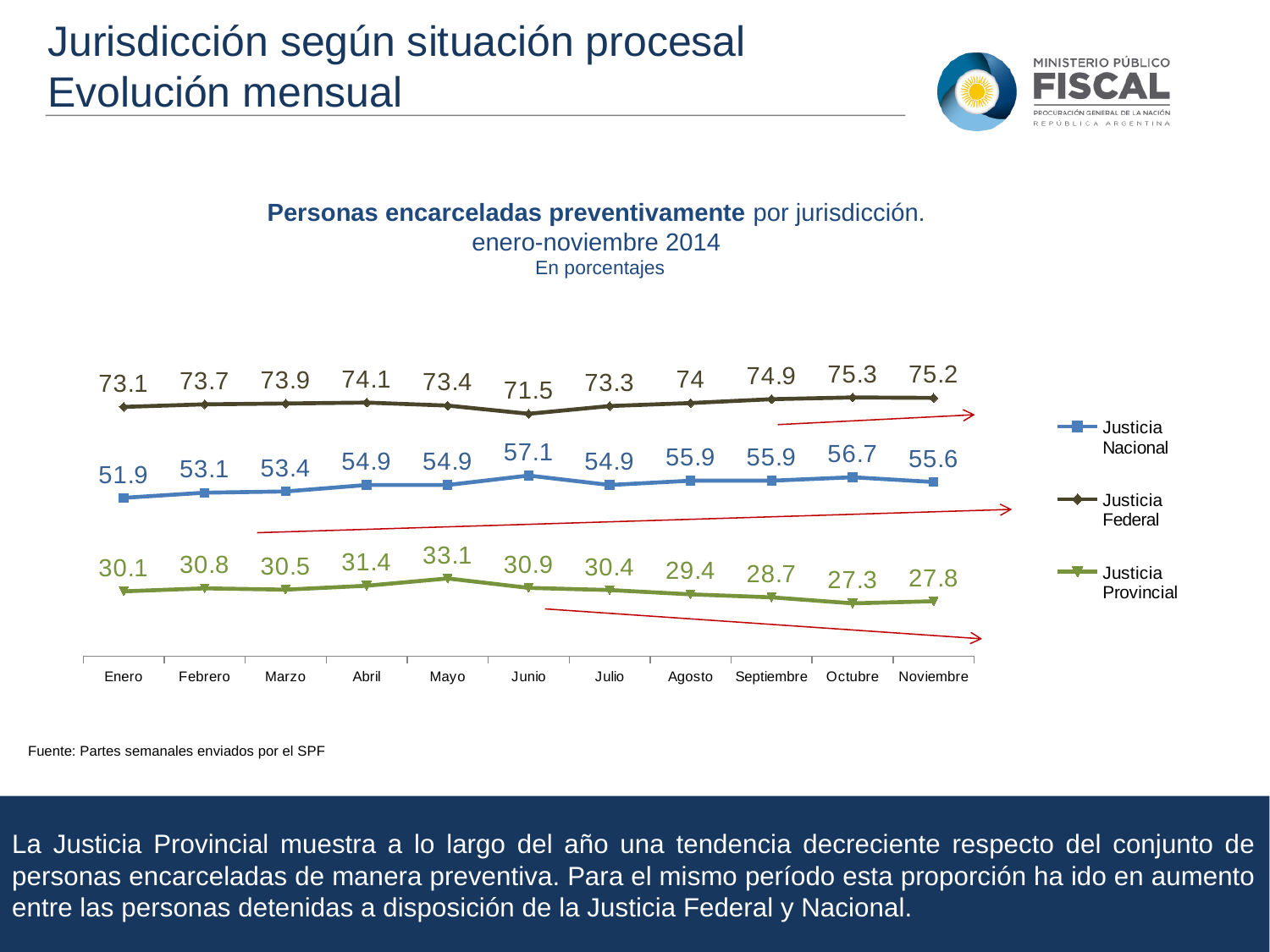
Does the Justicia Provincial series generally rise or fall from Mayo to Noviembre? Fall What is the value for Justicia Nacional in Enero? 51.9 How many series does the legend list? 3 Which series has the higher value in Octubre, Justicia Nacional or Justicia Provincial? Justicia Nacional In which month does Justicia Nacional reach its highest value? Junio How many months are shown on the x axis? 11 What type of chart is shown on the slide? Line chart What is the value for Justicia Provincial in Mayo? 33.1 In which month does Justicia Federal have its lowest value? Junio In which month does Justicia Provincial reach its highest value? Mayo What is the difference between the Justicia Federal value in Noviembre and in Enero? 2.1 What is the value for Justicia Federal in Junio? 71.5